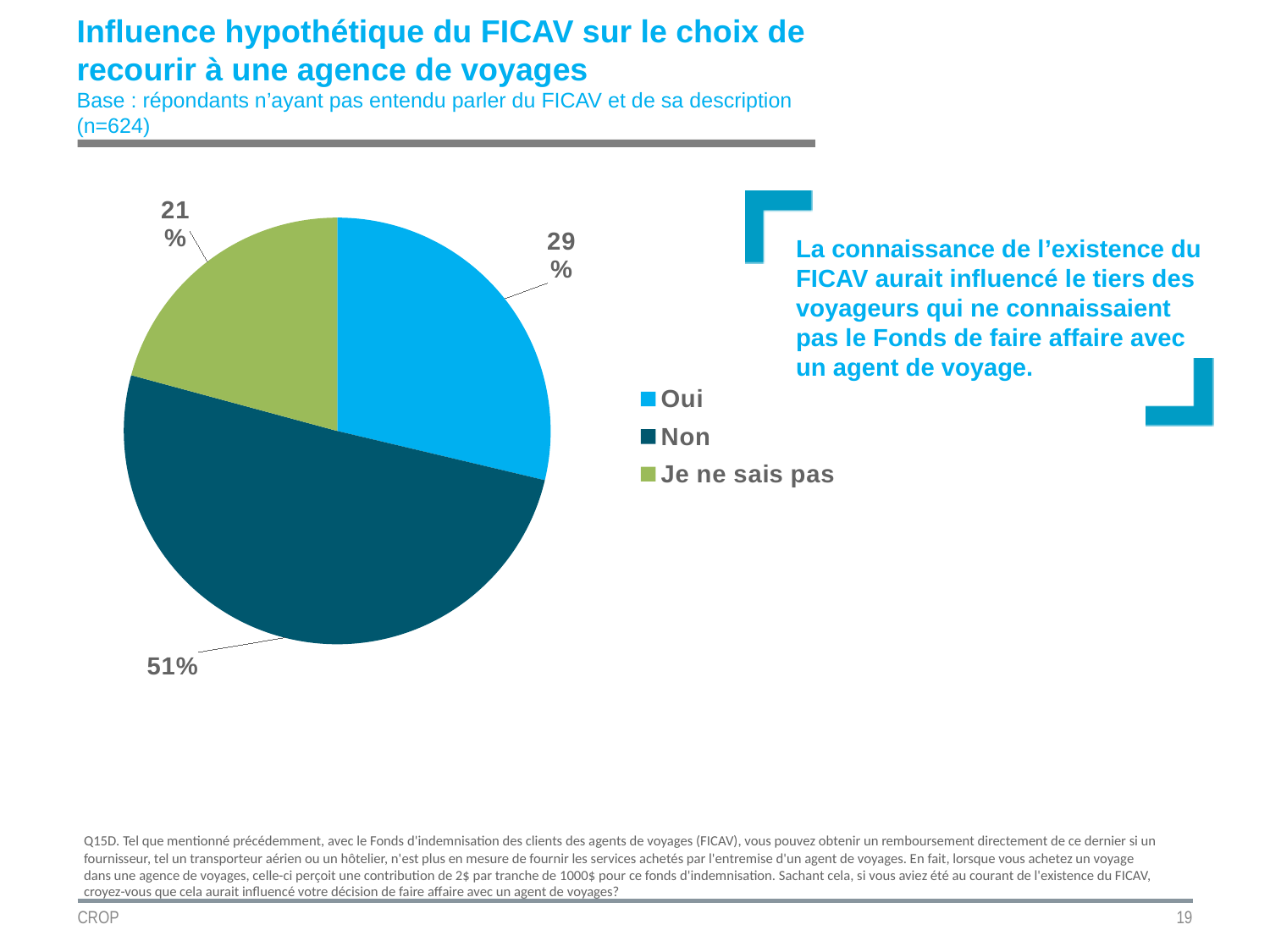
How many entries does the legend list? 3 What is the difference in percentage points between "Non" and "Oui"? 22 Which response has the largest slice of the pie? Non Which response has the smallest slice of the pie? Je ne sais pas What share of respondents answered "Je ne sais pas"? 21% What share of respondents answered "Non"? 51% What is the difference in percentage points between "Oui" and "Je ne sais pas"? 8 What share of respondents answered "Oui"? 29% How many slices does the pie chart have? 3 What kind of chart is shown on the slide? pie chart Which is larger, the share for "Oui" or the share for "Je ne sais pas"? Oui What colour is the "Non" slice in the pie chart? dark teal